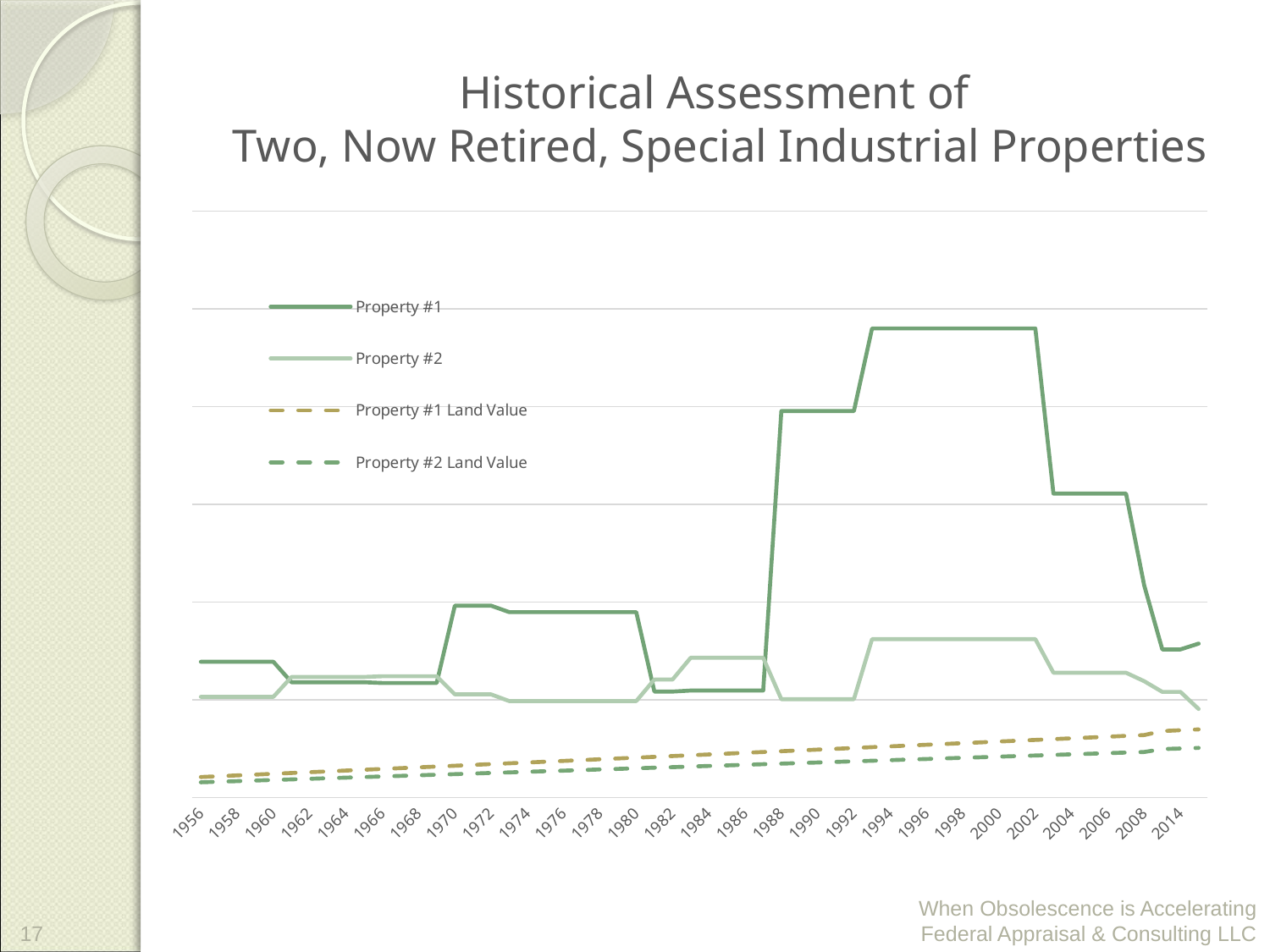
What is the title of the chart on the slide? Historical Assessment of Two, Now Retired, Special Industrial Properties How many series does the legend list? 4 Does Property #1 Land Value generally rise or fall from 1956 to 2014? rise Which series has the lowest value in 1956? Property #2 Land Value For Property #1, which year has the larger value: 1986 or 1996? 1996 In 2014, which is larger: Property #1 Land Value or Property #2 Land Value? Property #1 Land Value Does Property #2 rise or fall from 2002 to 2014? fall What kind of chart is shown on the slide? line chart How are the land value series drawn differently from the property assessment series? as dashed lines In 1996, which is larger: Property #1 or Property #2? Property #1 Which series has the highest value in 2000? Property #1 Does Property #1 rise or fall from 2002 to 2008? fall